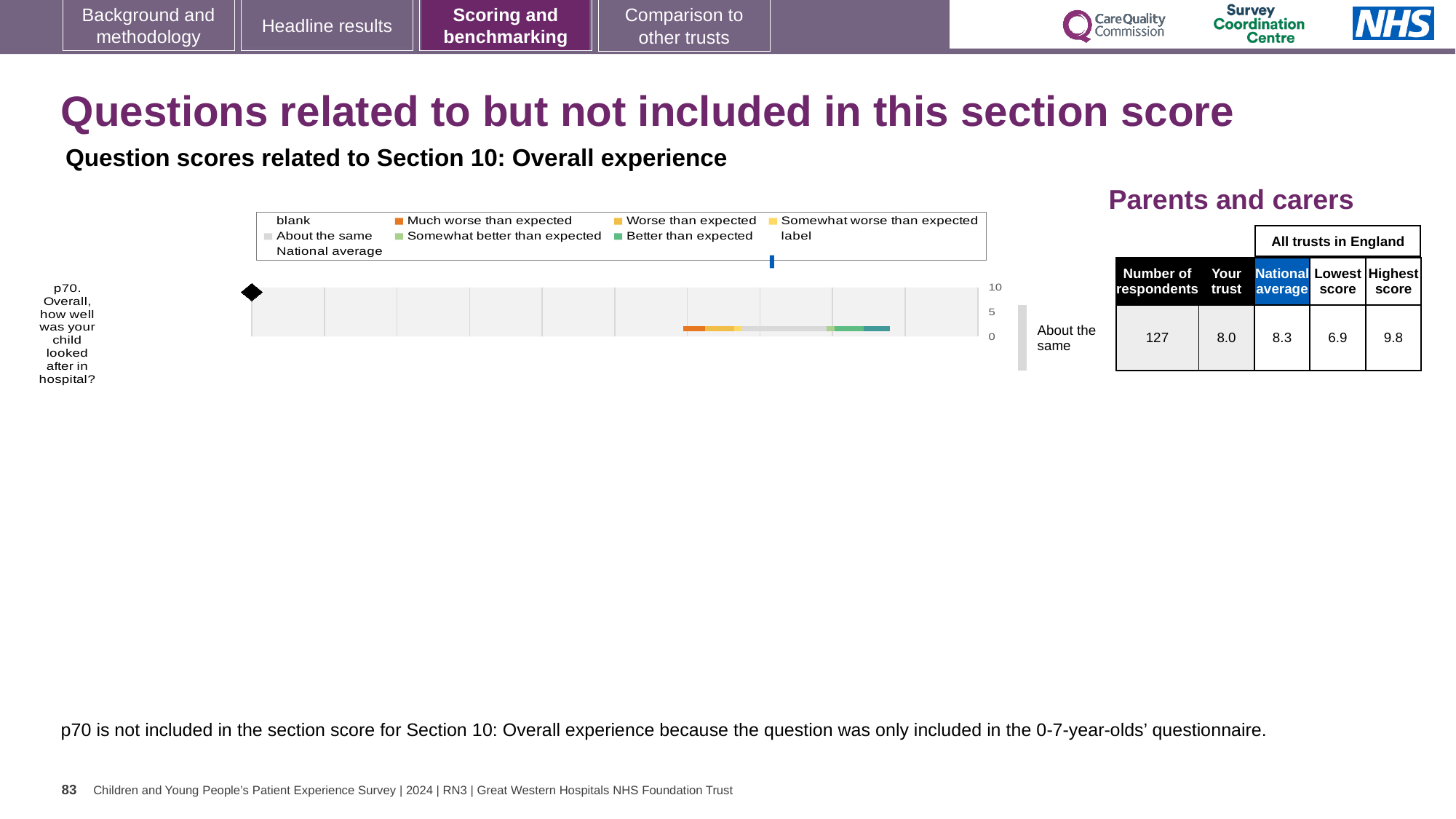
How many survey questions are plotted in the chart? 1 What is the highest value shown on the chart's vertical axis? 10 What is the difference between the highest score and the lowest score for p70? 2.9 What is the highest score among all trusts in England for p70? 9.8 What benchmark category label is shown next to the bar for p70? About the same By how much does the national average exceed the 'Your trust' score for p70? 0.3 What is the national average score for p70? 8.3 For p70, which is larger: the 'Your trust' score or the national average? National average How many respondents answered p70 for this trust? 127 What is the lowest score among all trusts in England for p70? 6.9 What is the 'Your trust' score for p70 (Overall, how well was your child looked after in hospital?)? 8.0 What kind of chart is used to show the p70 question score? bar chart